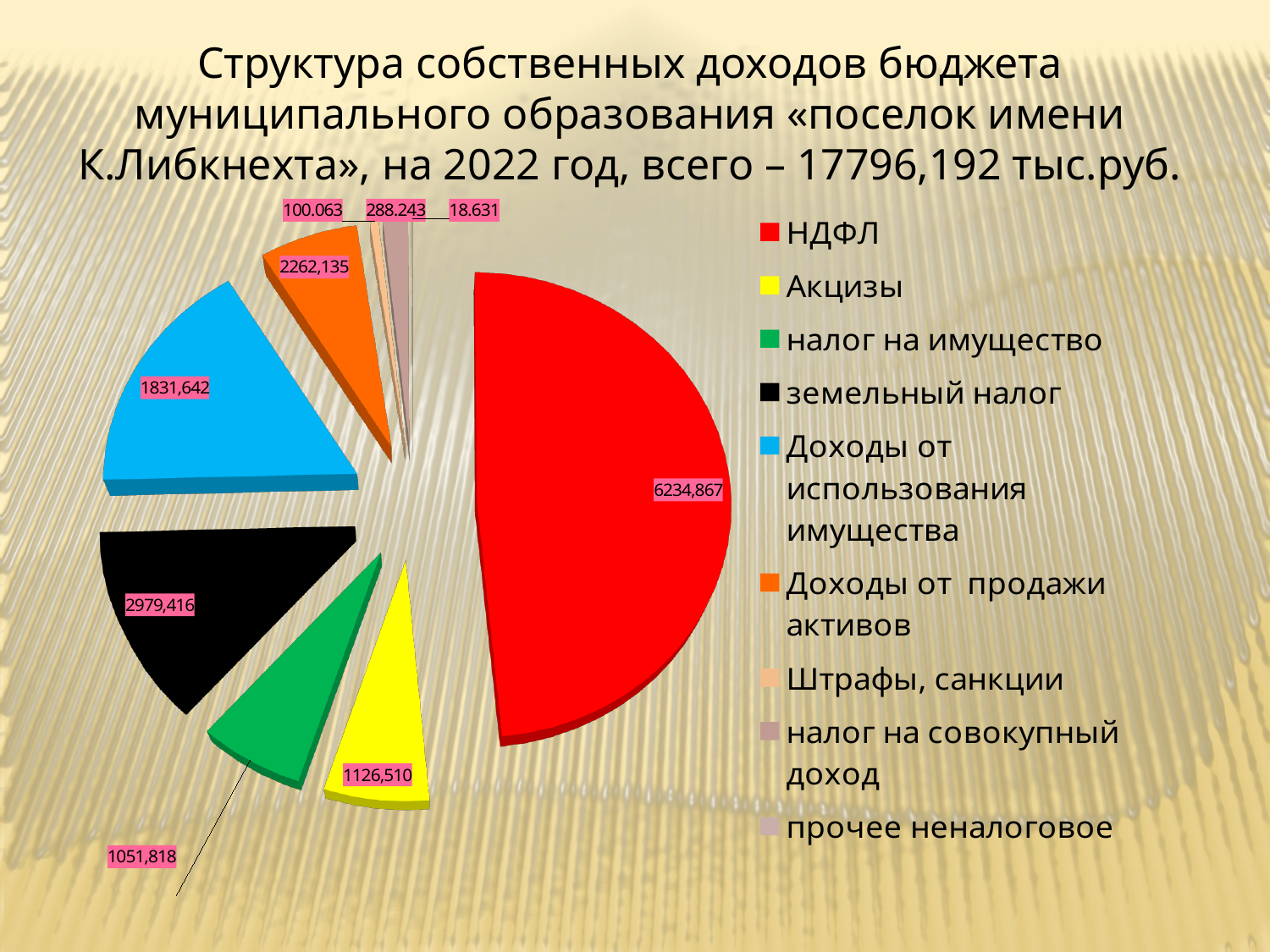
What is the value shown for Акцизы? 1126,510 What is the value shown for НДФЛ? 6234,867 Which is larger, земельный налог or Доходы от использования имущества? земельный налог What is the value shown for Доходы от использования имущества? 1831,642 How many categories does the pie chart have? 9 What is the difference between the values for НДФЛ and земельный налог? 3255,451 Which category has the smallest slice of the pie? прочее неналоговое What total amount is stated in the chart title for 2022? 17796,192 тыс.руб. Which category has the largest slice of the pie? НДФЛ What is the value shown for Доходы от продажи активов? 2262,135 What is the value shown for земельный налог? 2979,416 What type of chart is shown on the slide? pie chart